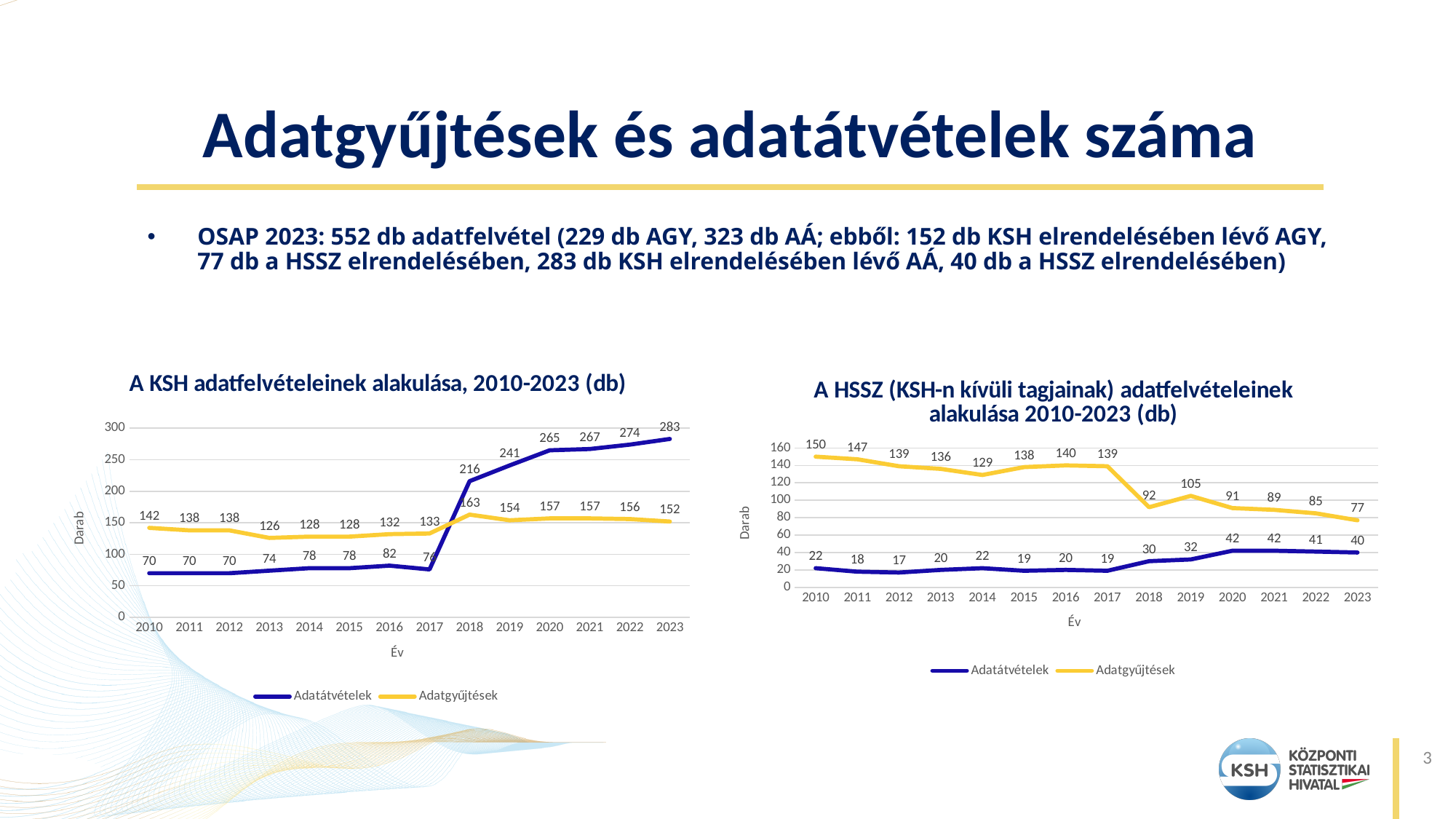
How many years are shown on the x axis of the chart 'A HSSZ (KSH-n kívüli tagjainak) adatfelvételeinek alakulása 2010-2023 (db)'? 14 In the chart 'A KSH adatfelvételeinek alakulása, 2010-2023 (db)', what is the value of Adatgyűjtések in 2018? 163 In the chart 'A HSSZ (KSH-n kívüli tagjainak) adatfelvételeinek alakulása 2010-2023 (db)', what is the value of Adatátvételek in 2019? 32 In the chart 'A KSH adatfelvételeinek alakulása, 2010-2023 (db)', what is the value of Adatátvételek in 2023? 283 In the chart 'A HSSZ (KSH-n kívüli tagjainak) adatfelvételeinek alakulása 2010-2023 (db)', in which year is Adatátvételek lowest? 2012 In the chart 'A KSH adatfelvételeinek alakulása, 2010-2023 (db)', does Adatátvételek rise or fall between 2017 and 2023? rise In the chart 'A HSSZ (KSH-n kívüli tagjainak) adatfelvételeinek alakulása 2010-2023 (db)', what is the difference between Adatgyűjtések in 2010 and in 2023? 73 What type of chart is 'A KSH adatfelvételeinek alakulása, 2010-2023 (db)'? line chart In the chart 'A KSH adatfelvételeinek alakulása, 2010-2023 (db)', in which year is Adatgyűjtések lowest? 2013 In the chart 'A KSH adatfelvételeinek alakulása, 2010-2023 (db)', which series is higher in 2017, Adatátvételek or Adatgyűjtések? Adatgyűjtések In the chart 'A HSSZ (KSH-n kívüli tagjainak) adatfelvételeinek alakulása 2010-2023 (db)', what is the value of Adatgyűjtések in 2010? 150 In the chart 'A KSH adatfelvételeinek alakulása, 2010-2023 (db)', what is the difference between Adatátvételek and Adatgyűjtések in 2023? 131